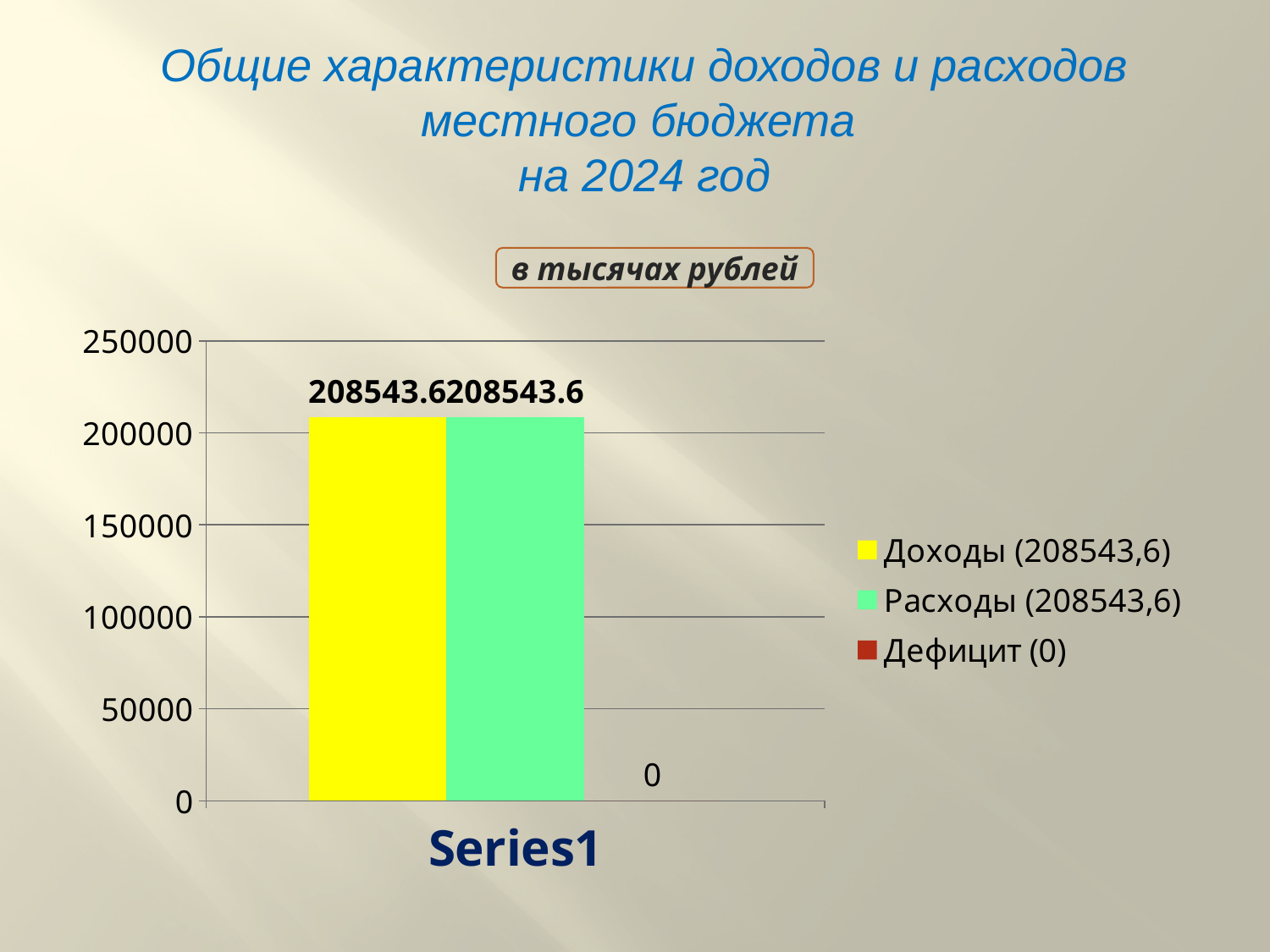
What is the difference between the Доходы value and the Дефицит value? 208543.6 What is the difference between the Доходы and Расходы values? 0 Which series has the lowest value? Дефицит What is the category label shown on the x axis? Series1 What is the value of the Доходы bar? 208543.6 What colour is the Расходы series in the legend? green What kind of chart is shown on the slide? bar chart Is the value for Расходы greater or less than 250000? less What is the value shown for Дефицит? 0 Is the value for Доходы greater or less than 200000? greater How many series does the legend list? 3 What is the value of the Расходы bar? 208543.6